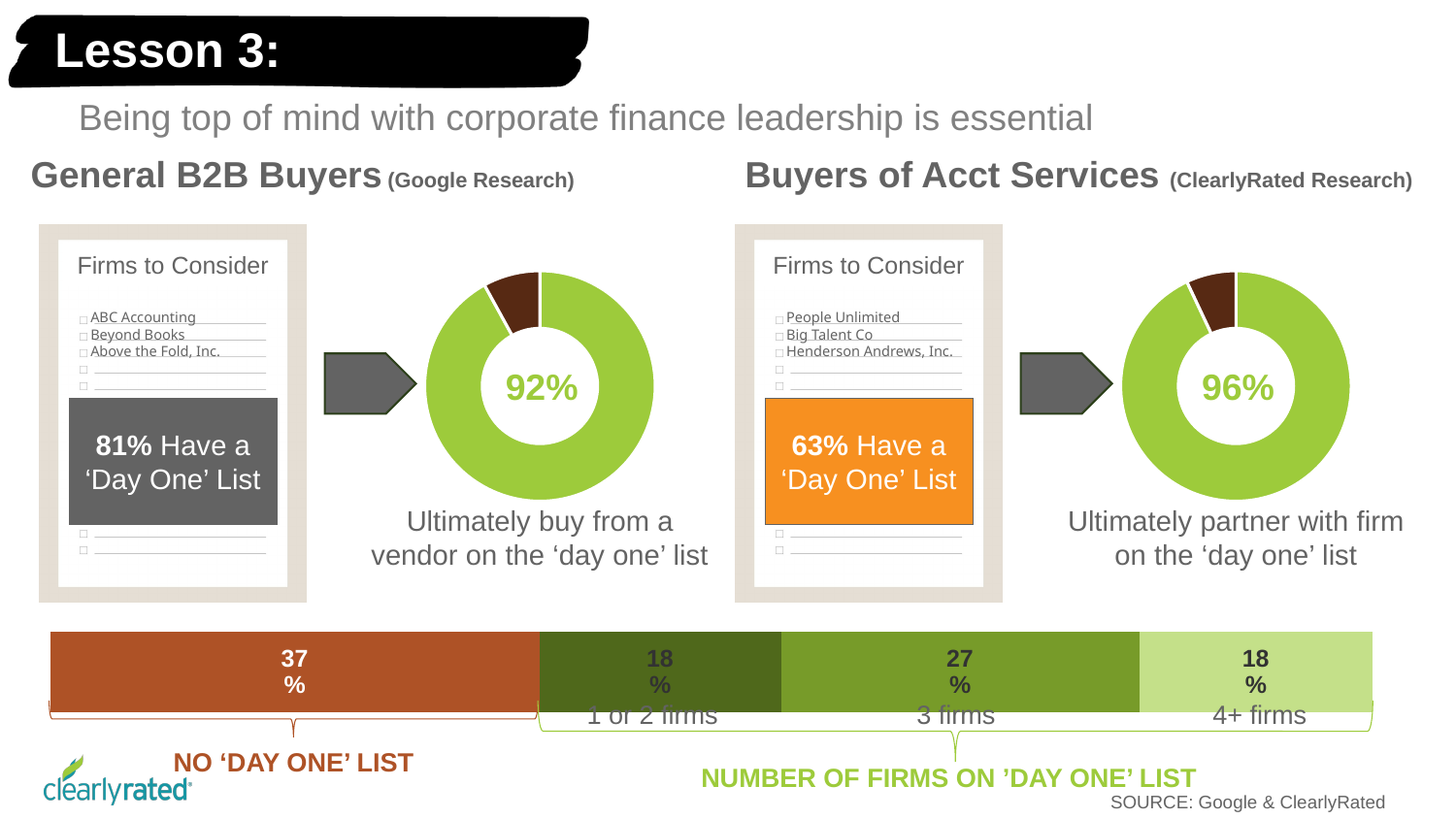
In the stacked bar at the bottom of the slide, how many segments are there? 4 In the donut chart under 'Buyers of Acct Services', what percentage is shown in the centre? 96% In the donut chart under 'General B2B Buyers', what percentage is shown in the centre? 92% In the stacked bar at the bottom of the slide, which segment has the largest percentage? NO 'DAY ONE' LIST In the stacked bar at the bottom of the slide, what is the difference between the '3 firms' segment and the '4+ firms' segment? 9% In the stacked bar at the bottom of the slide, what percentage is shown for '3 firms'? 27% Which donut chart shows the larger percentage, the one under 'General B2B Buyers' or the one under 'Buyers of Acct Services'? Buyers of Acct Services In the stacked bar at the bottom of the slide, what percentage is shown for 'NO ‘DAY ONE’ LIST'? 37% In the stacked bar at the bottom of the slide, what percentage is shown for '1 or 2 firms'? 18% In the stacked bar at the bottom of the slide, what is the combined percentage of the three segments under 'NUMBER OF FIRMS ON ’DAY ONE’ LIST'? 63% What is the difference between the percentages shown in the two donut charts? 4% What kind of chart is used to show the 92% and 96% figures? Donut chart